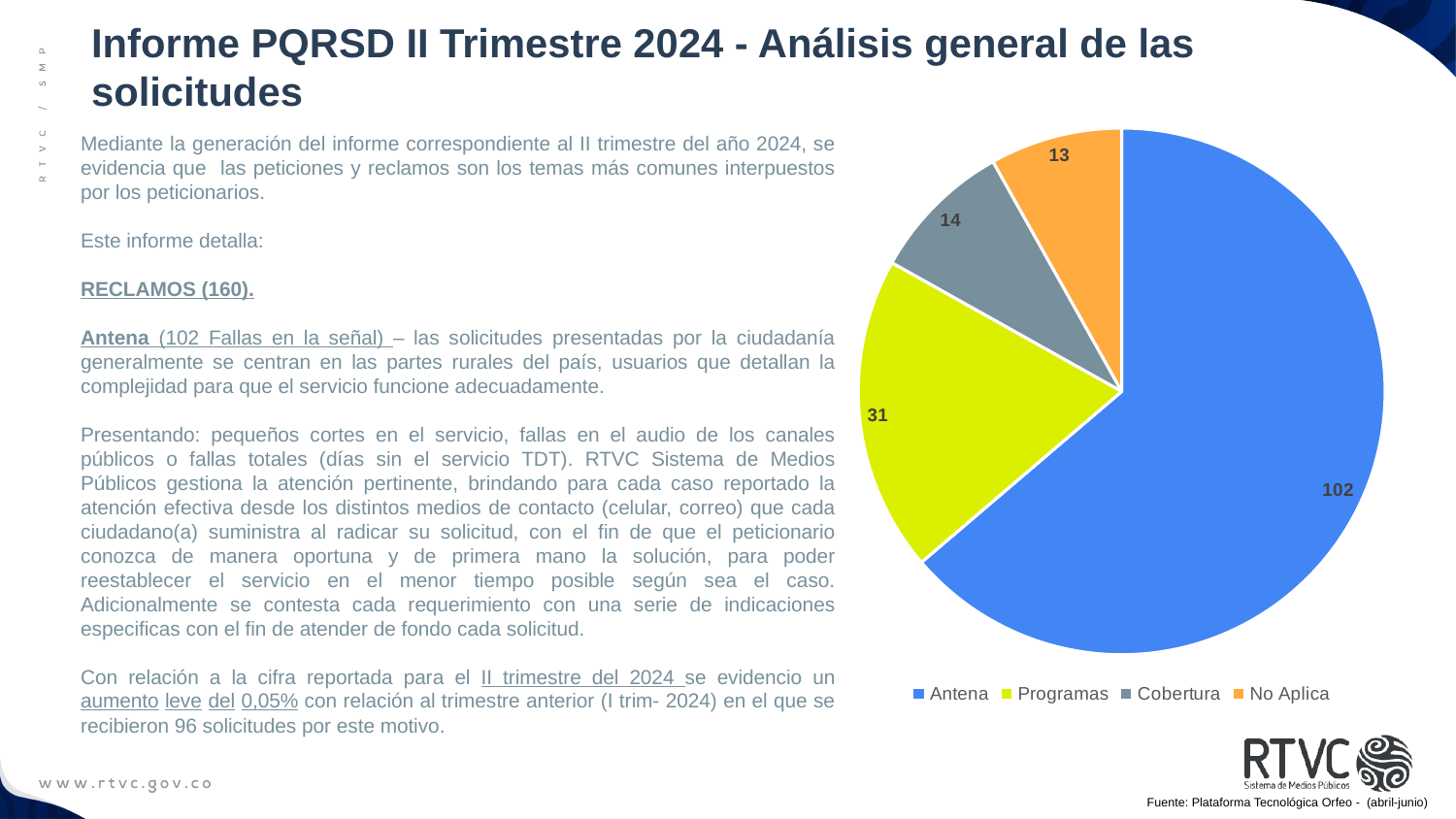
Which is larger, the value for Cobertura or the value for No Aplica? Cobertura What type of chart is shown on the slide? Pie chart What is the value for No Aplica in the pie chart? 13 What is the value for Cobertura in the pie chart? 14 How many categories does the pie chart show? 4 What is the value for Programas in the pie chart? 31 Which category has the largest slice in the pie chart? Antena Which category has the smallest slice in the pie chart? No Aplica What is the value for Antena in the pie chart? 102 What is the difference between the values for Antena and Programas? 71 What is the total of all slices in the pie chart? 160 What colour is the Programas slice in the pie chart? Yellow-green